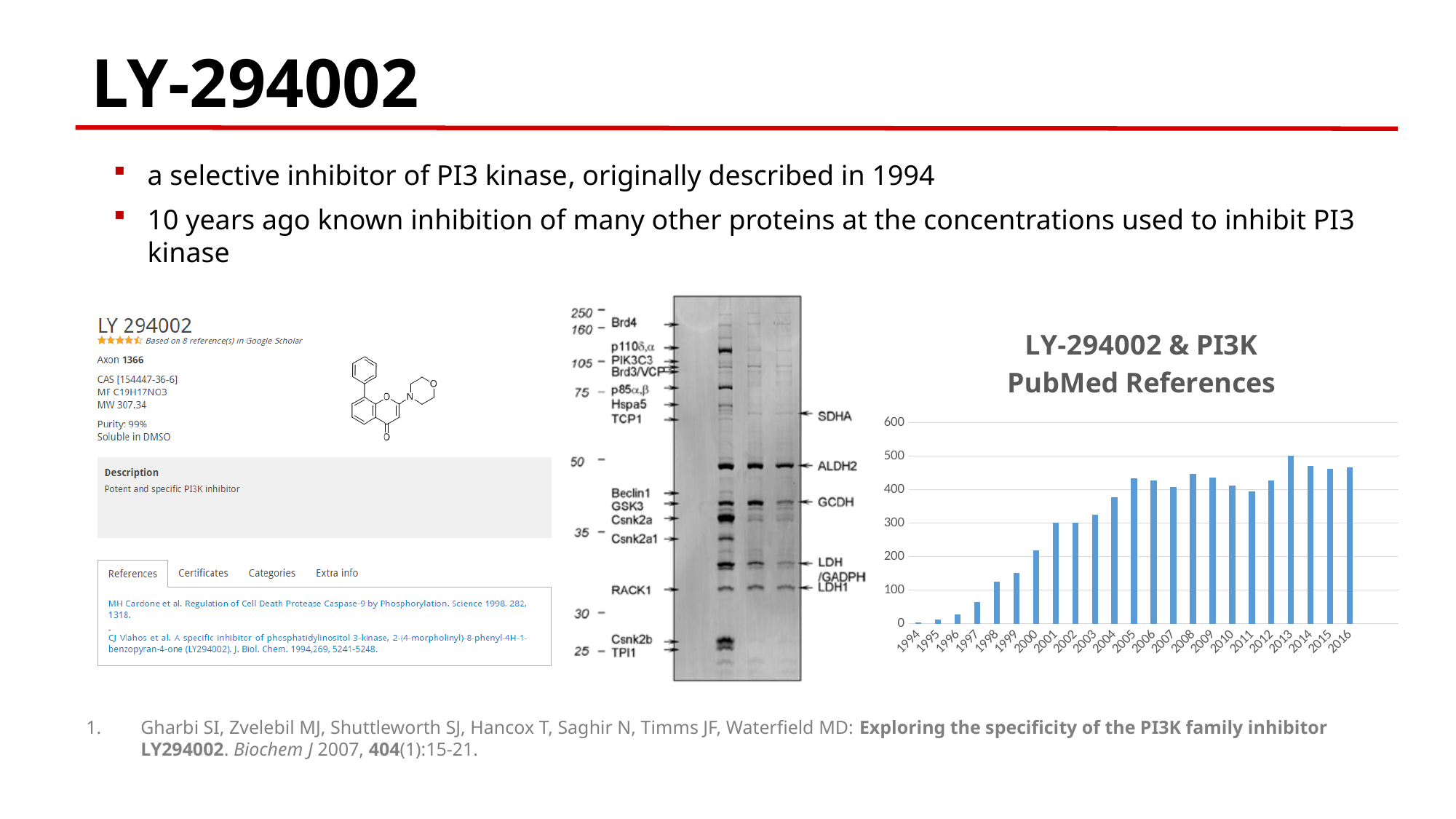
In the "LY-294002 & PI3K PubMed References" chart, is the value for 2000 greater or less than 200? greater In the "LY-294002 & PI3K PubMed References" chart, which year has the larger value, 1998 or 2000? 2000 In the "LY-294002 & PI3K PubMed References" chart, which year has the lowest bar? 1994 In the "LY-294002 & PI3K PubMed References" chart, do the values generally rise or fall from 1994 to 2013? rise What kind of chart is the "LY-294002 & PI3K PubMed References" chart? bar chart In the "LY-294002 & PI3K PubMed References" chart, is the value for 1997 greater or less than 100? less In the "LY-294002 & PI3K PubMed References" chart, is the value for 2004 greater or less than 400? less What is the highest tick value shown on the y axis of the "LY-294002 & PI3K PubMed References" chart? 600 In the "LY-294002 & PI3K PubMed References" chart, which year has the highest bar? 2013 In the "LY-294002 & PI3K PubMed References" chart, which year has the larger value, 2011 or 2013? 2013 How many years are shown on the x axis of the "LY-294002 & PI3K PubMed References" chart? 23